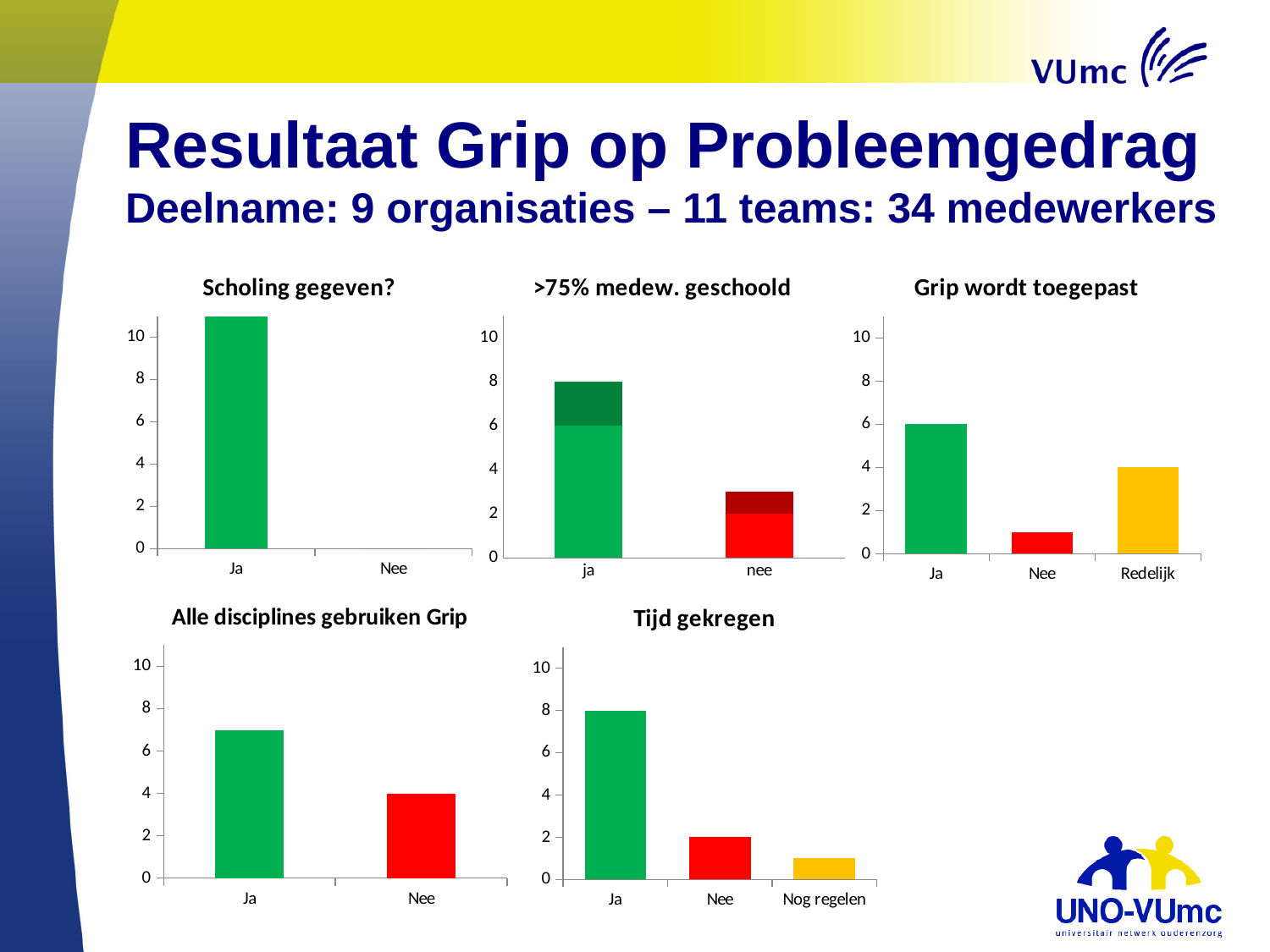
In the 'Tijd gekregen' chart, what is the value for Nee? 2 In the 'Scholing gegeven?' chart, is the value for Ja greater or less than 10? greater In the 'Tijd gekregen' chart, which category has the highest value? Ja In the 'Alle disciplines gebruiken Grip' chart, is the value for Ja greater or less than 6? greater In the 'Grip wordt toegepast' chart, what is the value for Ja? 6 In the 'Grip wordt toegepast' chart, what is the value for Redelijk? 4 In the 'Alle disciplines gebruiken Grip' chart, what is the value for Nee? 4 In the 'Tijd gekregen' chart, what is the value for Ja? 8 In the '>75% medew. geschoold' chart, is the total of the stacked bar for nee greater or less than 4? less How many categories are shown on the x axis of the 'Tijd gekregen' chart? 3 In the 'Grip wordt toegepast' chart, which category has the lowest value? Nee What kind of chart is the 'Alle disciplines gebruiken Grip' chart? Bar chart